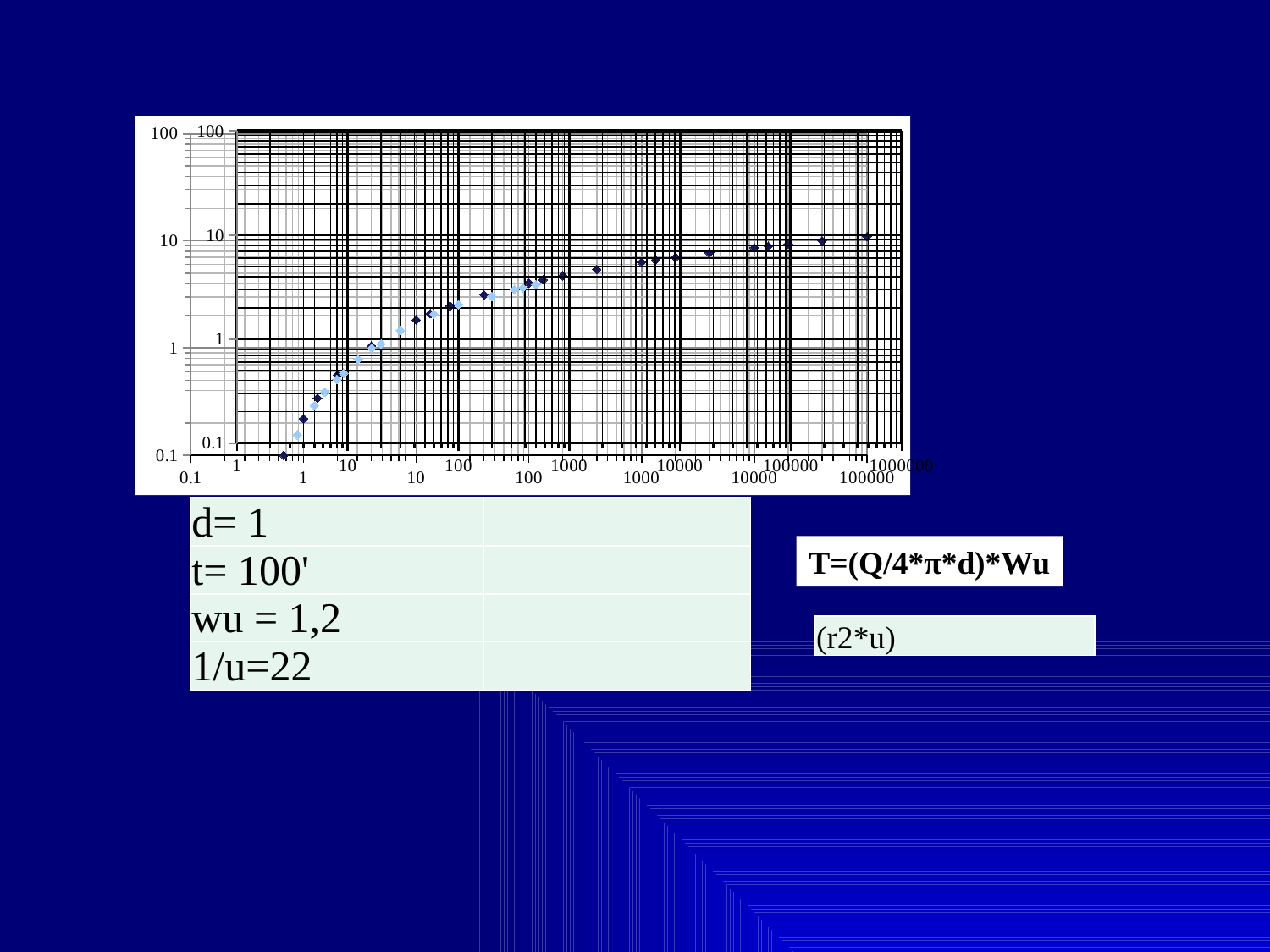
Do the plotted values rise or fall as you move from left to right along the x axis? rise Is the highest plotted value on the chart greater or less than 100? less Is the lowest plotted value on the chart greater or less than 1? less What is the lowest value labelled on the y axis of the chart? 0.1 What kind of chart is shown on the slide? scatter chart Are the plotted values at the right-hand end of the chart greater or less than 1? greater What is the highest value labelled on the y axis of the chart? 100